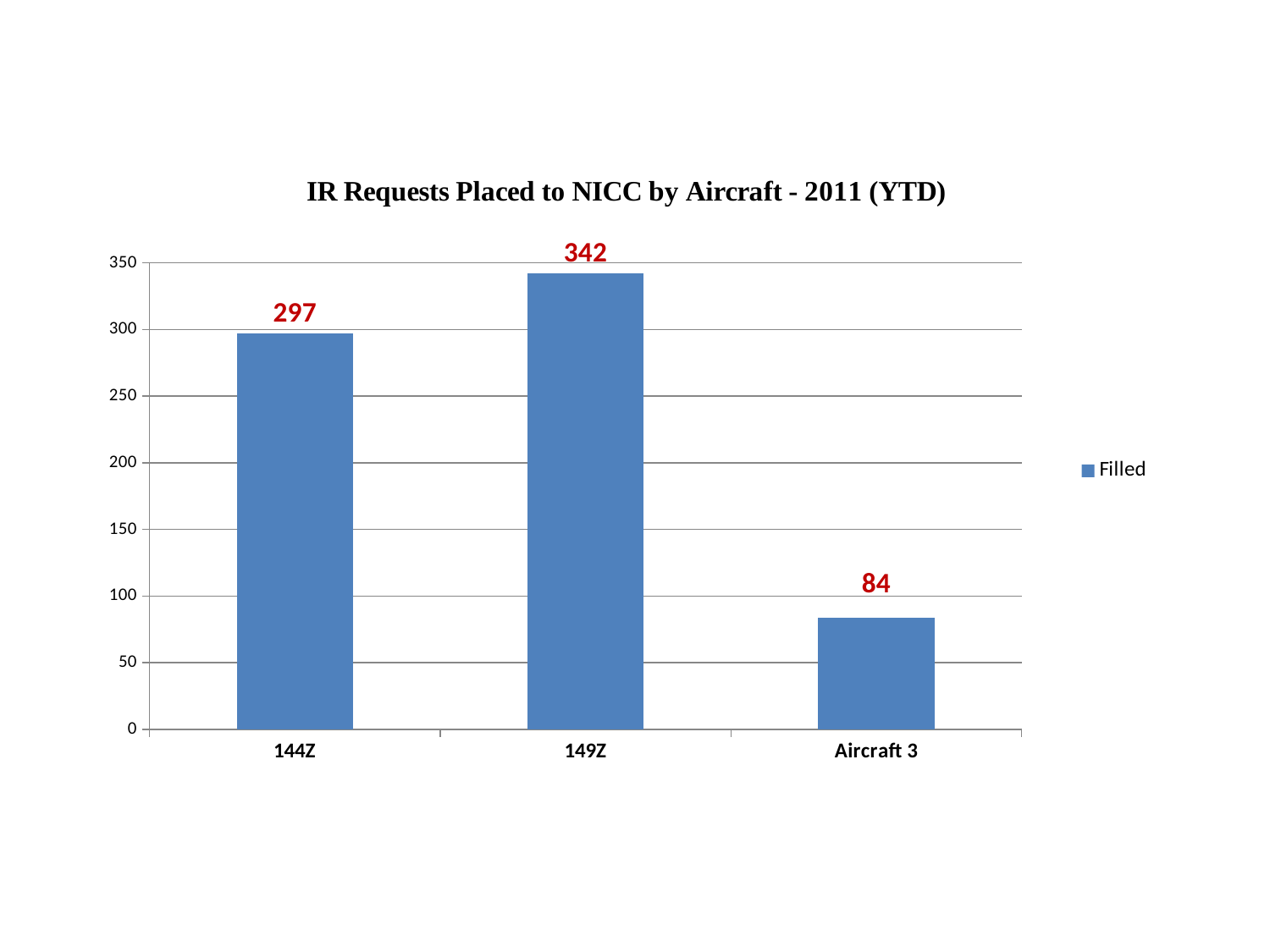
What is the difference between the values for 149Z and 144Z? 45 What is the value for 149Z? 342 What is the title of the chart? IR Requests Placed to NICC by Aircraft - 2011 (YTD) What is the value for Aircraft 3? 84 Is the value for 149Z greater or less than 300? greater What is the difference between the values for 144Z and Aircraft 3? 213 Which aircraft has the lowest number of IR requests? Aircraft 3 Which is larger, the value for 144Z or the value for Aircraft 3? 144Z How many aircraft categories are shown on the chart? 3 What kind of chart is shown on the slide? bar chart What is the value for 144Z? 297 Which aircraft has the highest number of IR requests? 149Z